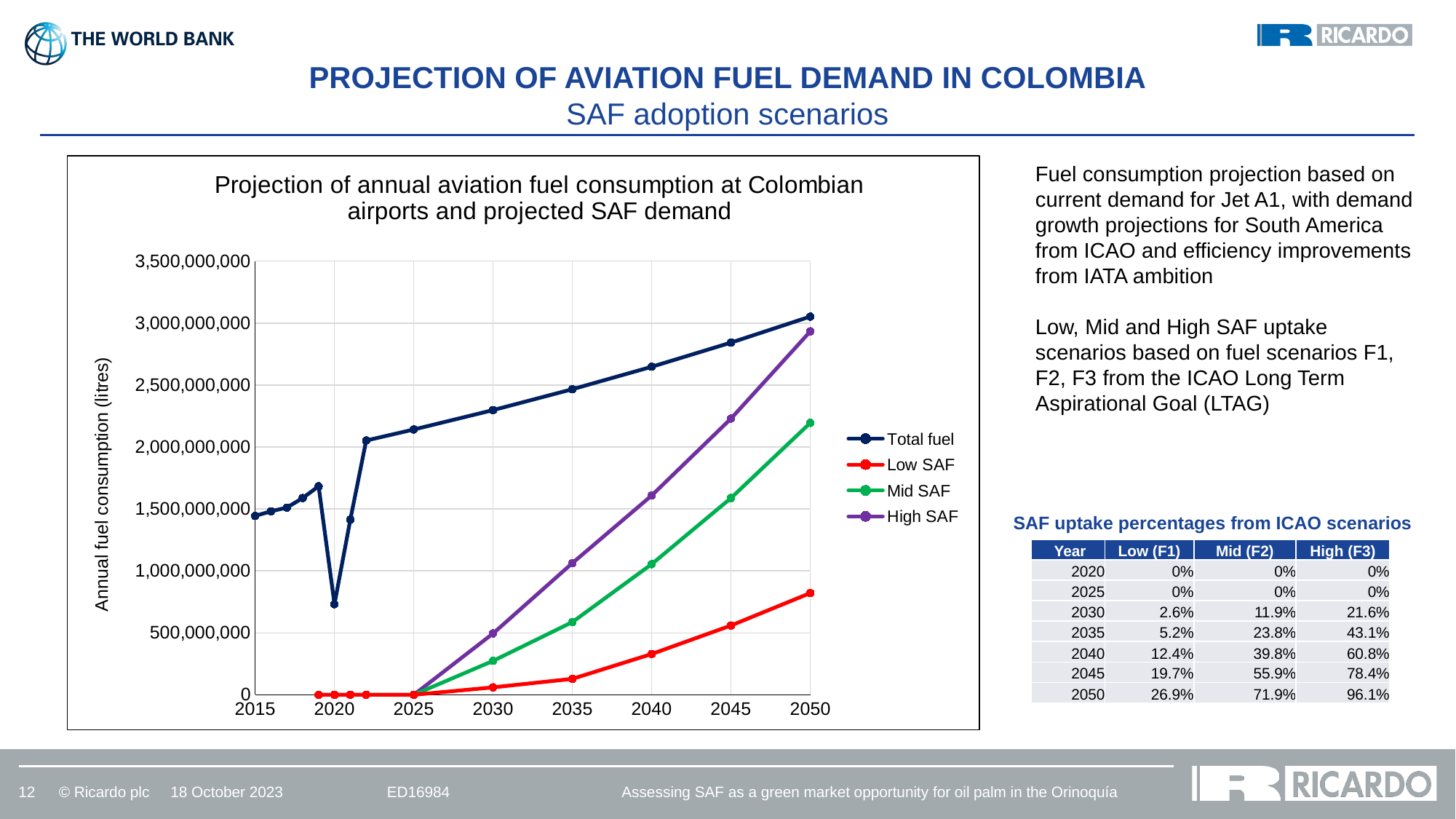
In 2050, which is larger: High SAF or Mid SAF? High SAF Does the Low SAF series rise or fall between 2025 and 2050? Rise Is the value for Low SAF in 2040 greater or less than 500,000,000? less Is the value for Total fuel in 2020 greater or less than 1,000,000,000? less Which series is plotted in green in the chart? Mid SAF What kind of chart is shown on the slide? Line chart Which series has the lowest value in 2050? Low SAF How many series does the chart legend list? 4 Is the value for Total fuel in 2050 greater or less than 2,500,000,000? greater Which series has the highest value in 2050? Total fuel What is the title of the chart? Projection of annual aviation fuel consumption at Colombian airports and projected SAF demand What is the value for Low SAF in 2025? 0